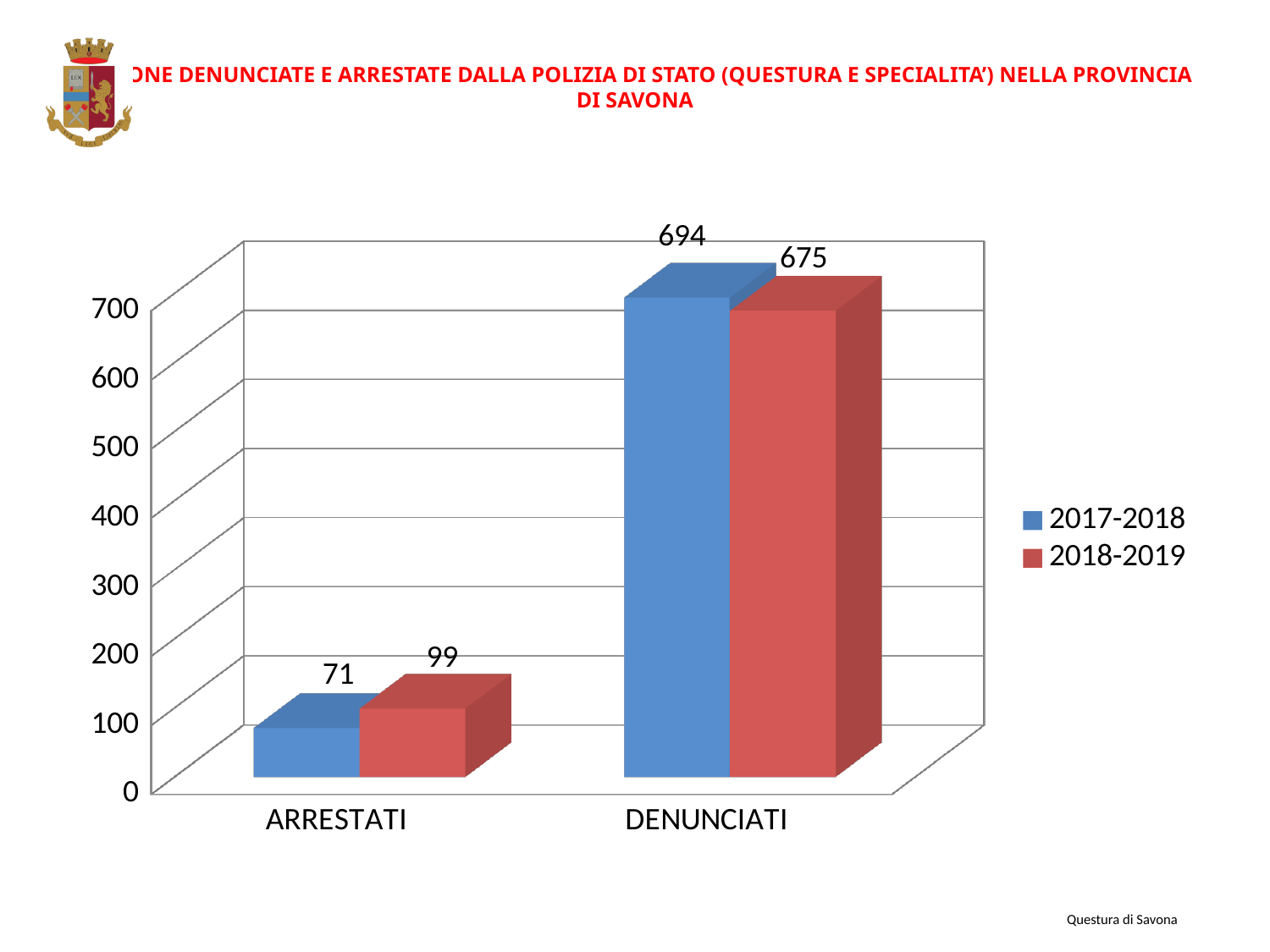
Which category has the lowest value in the 2017-2018 series? ARRESTATI What is the value for DENUNCIATI in the 2017-2018 series? 694 What kind of chart is shown on the slide? Bar chart What is the value for DENUNCIATI in the 2018-2019 series? 675 Which is larger for DENUNCIATI: the 2017-2018 value or the 2018-2019 value? 2017-2018 What is the value for ARRESTATI in the 2017-2018 series? 71 What is the difference between the 2017-2018 and 2018-2019 values for DENUNCIATI? 19 What is the value for ARRESTATI in the 2018-2019 series? 99 How many series does the legend list? 2 What is the difference between the 2018-2019 and 2017-2018 values for ARRESTATI? 28 Which category has the highest value in the 2018-2019 series? DENUNCIATI How many categories are shown on the x axis? 2